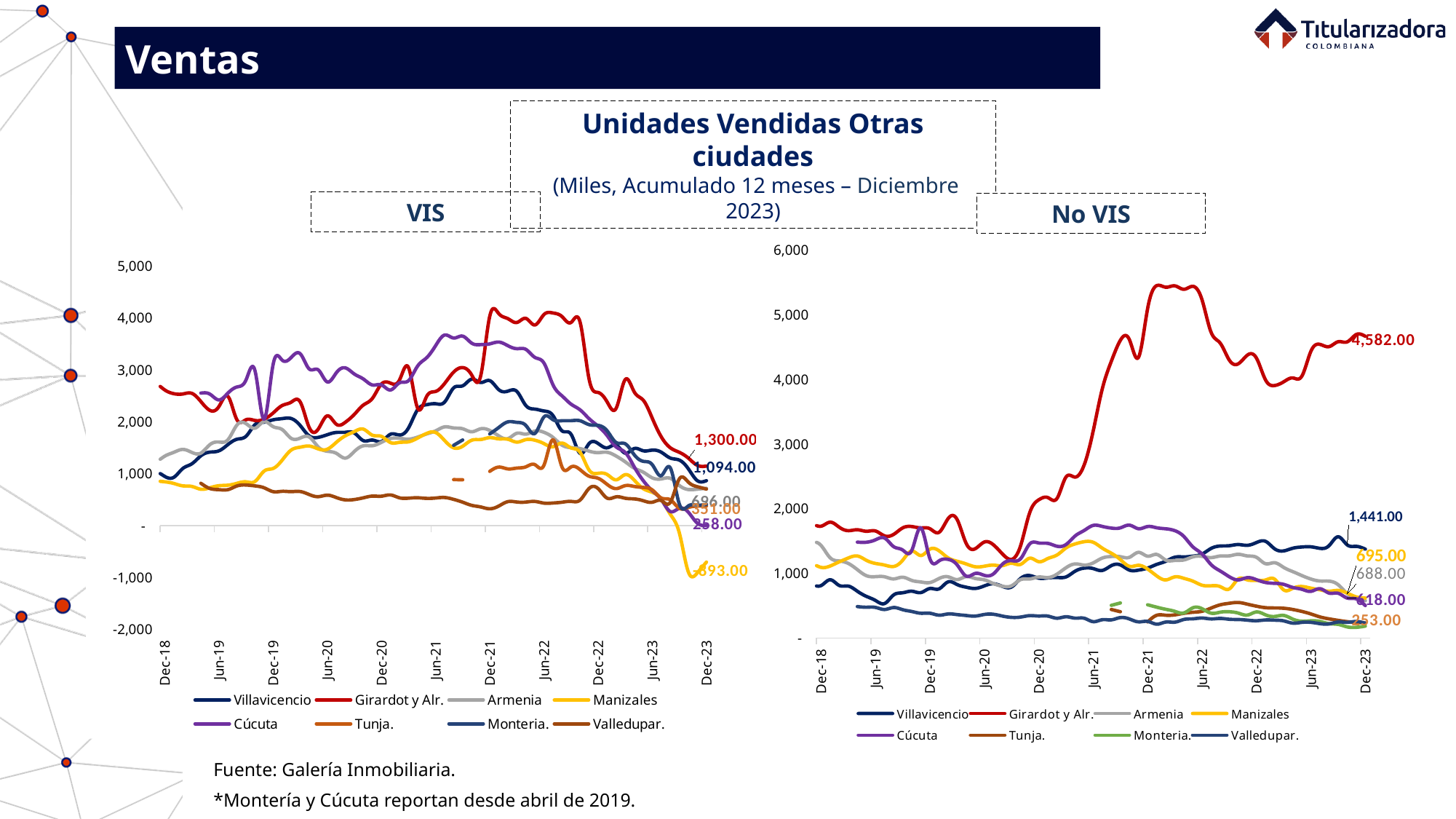
In the VIS chart, what is the value labelled for Girardot y Alr. at Dec-23? 1,300.00 What type of chart is used for the VIS and No VIS panels on this slide? Line chart In the No VIS chart, is the peak value of Girardot y Alr. greater or less than 5,000? greater In the VIS chart, which is larger at Dec-23: Girardot y Alr. or Villavicencio? Girardot y Alr. In the No VIS chart, which series has the highest value at Dec-23? Girardot y Alr. In the VIS chart, which series has the lowest value at Dec-23? Manizales In the No VIS chart, what is the value labelled for Villavicencio at Dec-23? 1,441.00 In the No VIS chart, what is the difference between the Dec-23 values of Girardot y Alr. and Villavicencio? 3,141.00 How many series does the legend of the No VIS chart list? 8 In the VIS chart, what is the value labelled for Villavicencio at Dec-23? 1,094.00 What source is cited below the charts? Galería Inmobiliaria In the No VIS chart, what is the value labelled for Girardot y Alr. at Dec-23? 4,582.00